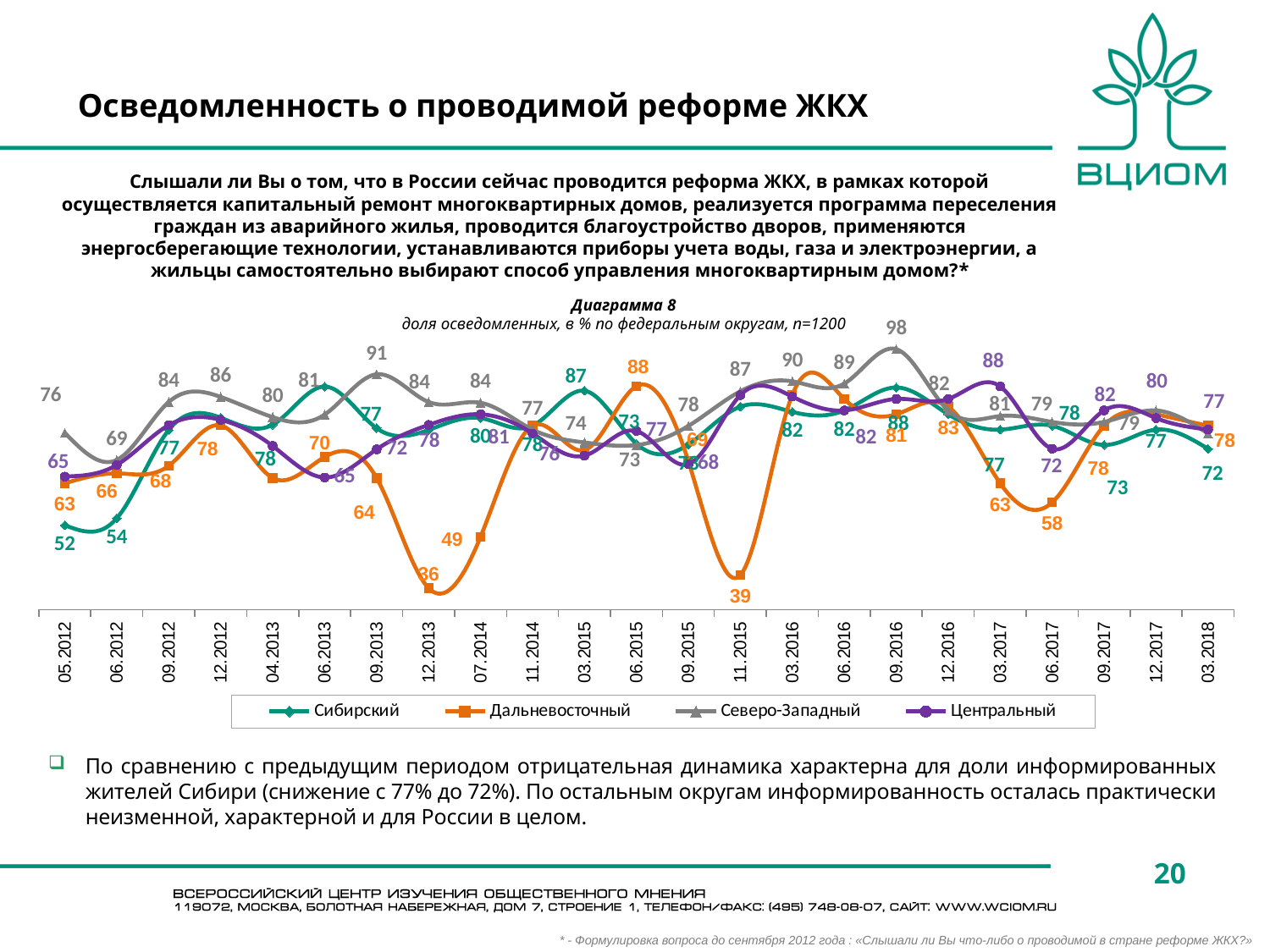
By how much did the value for Сибирский change between 12.2017 and 03.2018? 5 At which time point does Северо-Западный reach its highest value? 09.2016 What is the value for Сибирский in 05.2012? 52 In 05.2012, which series has the larger value: Северо-Западный or Сибирский? Северо-Западный Which series is shown in orange in the legend? Дальневосточный How many series does the legend list? 4 What is the value for Дальневосточный in 12.2013? 36 What is the value for Северо-Западный in 09.2016? 98 What kind of chart is shown on the slide? line chart What is the value for Дальневосточный in 11.2015? 39 At which time point does Дальневосточный reach its lowest value? 12.2013 How many time points are shown on the x axis? 23